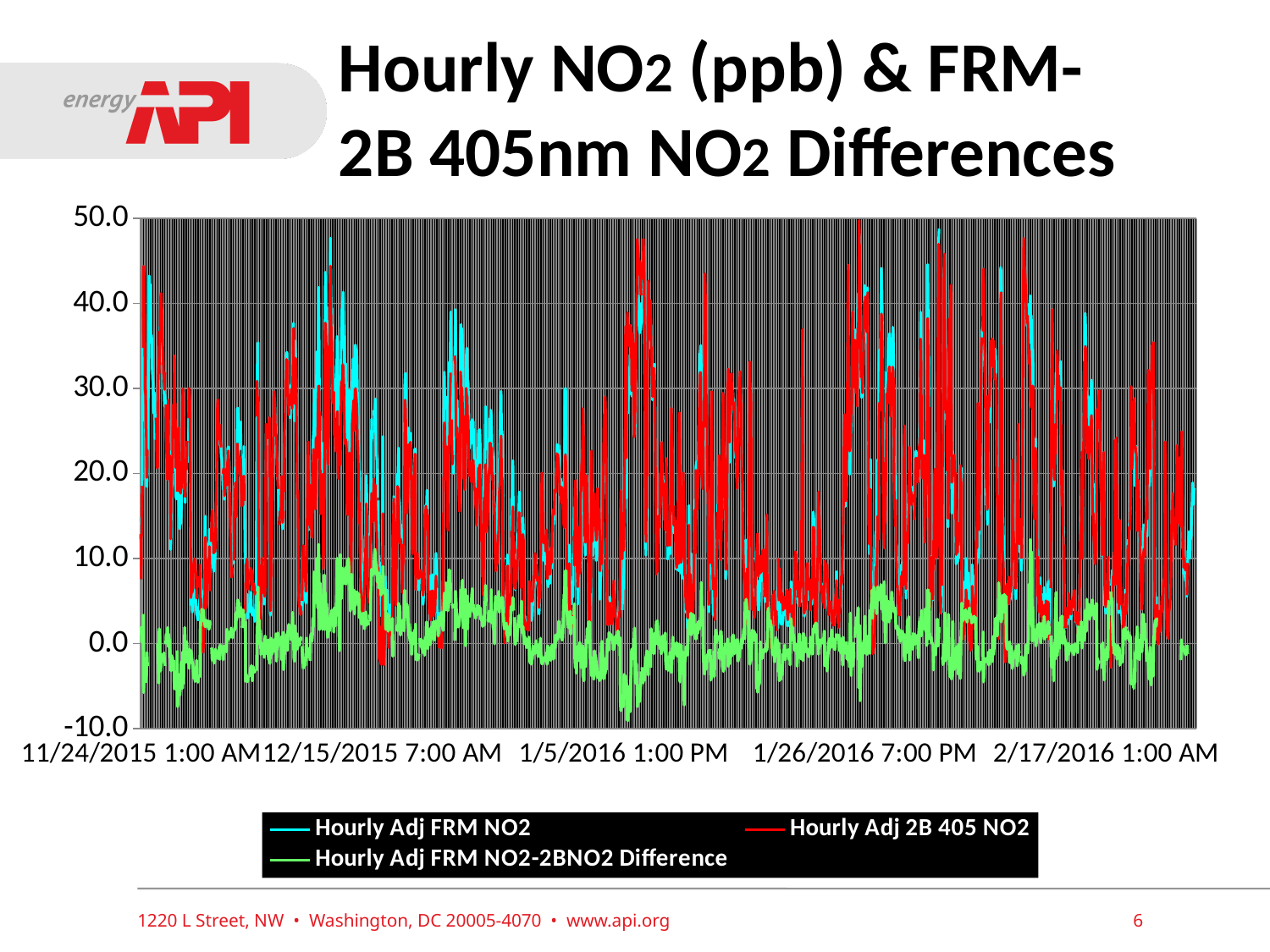
What is the lowest value shown on the y axis? -10.0 What is the first date label on the x axis? 11/24/2015 1:00 AM What is the title of the chart? Hourly NO2 (ppb) & FRM-2B 405nm NO2 Differences How many date labels are shown on the x axis? 5 Which series reaches higher values overall, Hourly Adj 2B 405 NO2 or Hourly Adj FRM NO2-2BNO2 Difference? Hourly Adj 2B 405 NO2 What is the last date label on the x axis? 2/17/2016 1:00 AM How many series does the legend list? 3 What is the highest value shown on the y axis? 50.0 Does the Hourly Adj FRM NO2-2BNO2 Difference series stay mostly greater or less than 10.0? less What kind of chart is shown on the slide? line chart Which series is drawn in green? Hourly Adj FRM NO2-2BNO2 Difference